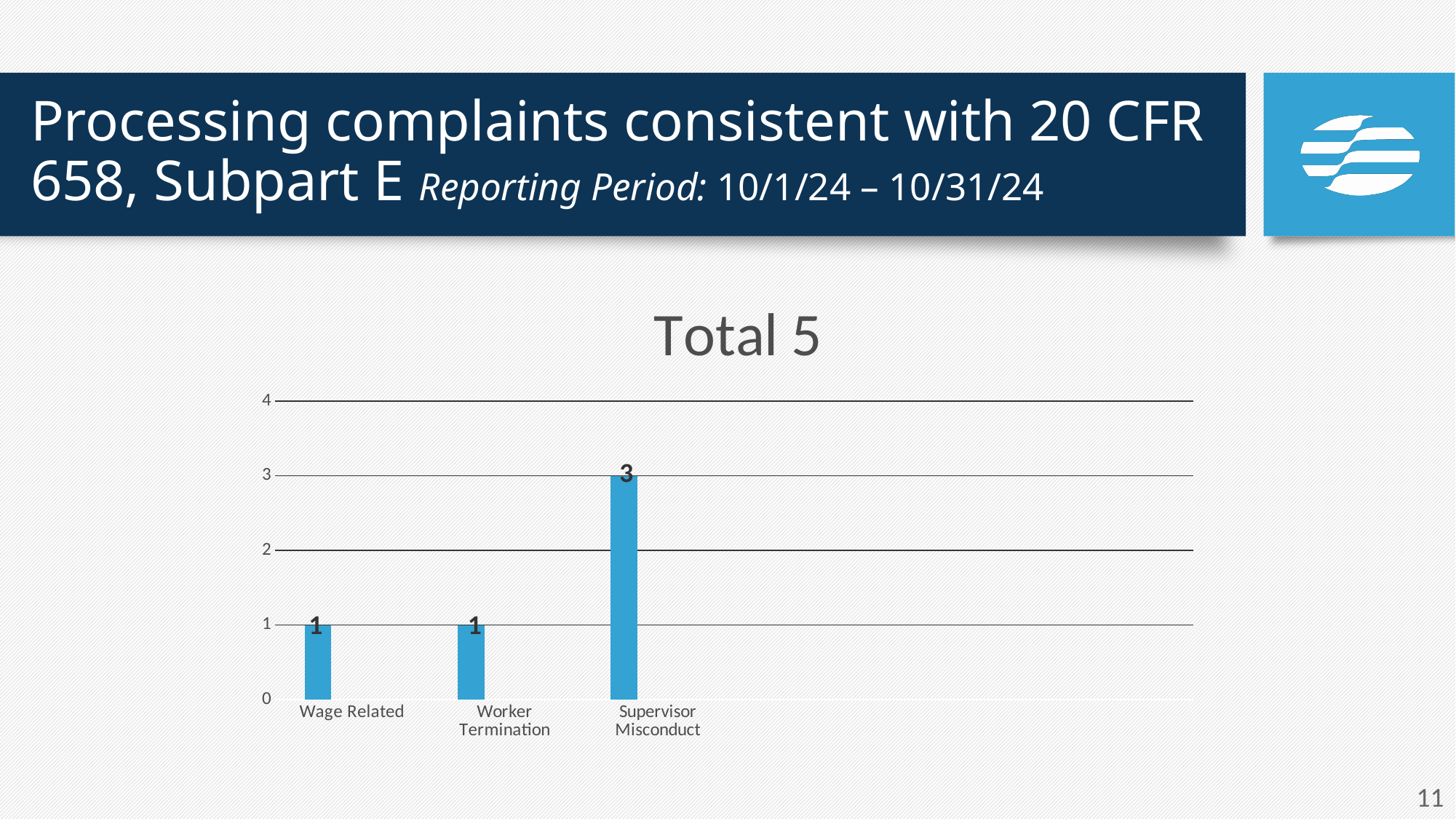
What kind of chart is shown on the slide? bar chart Is the value for Supervisor Misconduct greater or less than 2? greater What is the value for Supervisor Misconduct? 3 Which is larger, the value for Supervisor Misconduct or the value for Worker Termination? Supervisor Misconduct How many categories are shown on the x axis? 3 What is the sum of the values for all three categories? 5 What is the value for Wage Related? 1 What is the value for Worker Termination? 1 Which category has the highest value? Supervisor Misconduct What is the difference between the values for Supervisor Misconduct and Wage Related? 2 What is the highest value shown on the y axis? 4 What is the title of the chart? Total 5